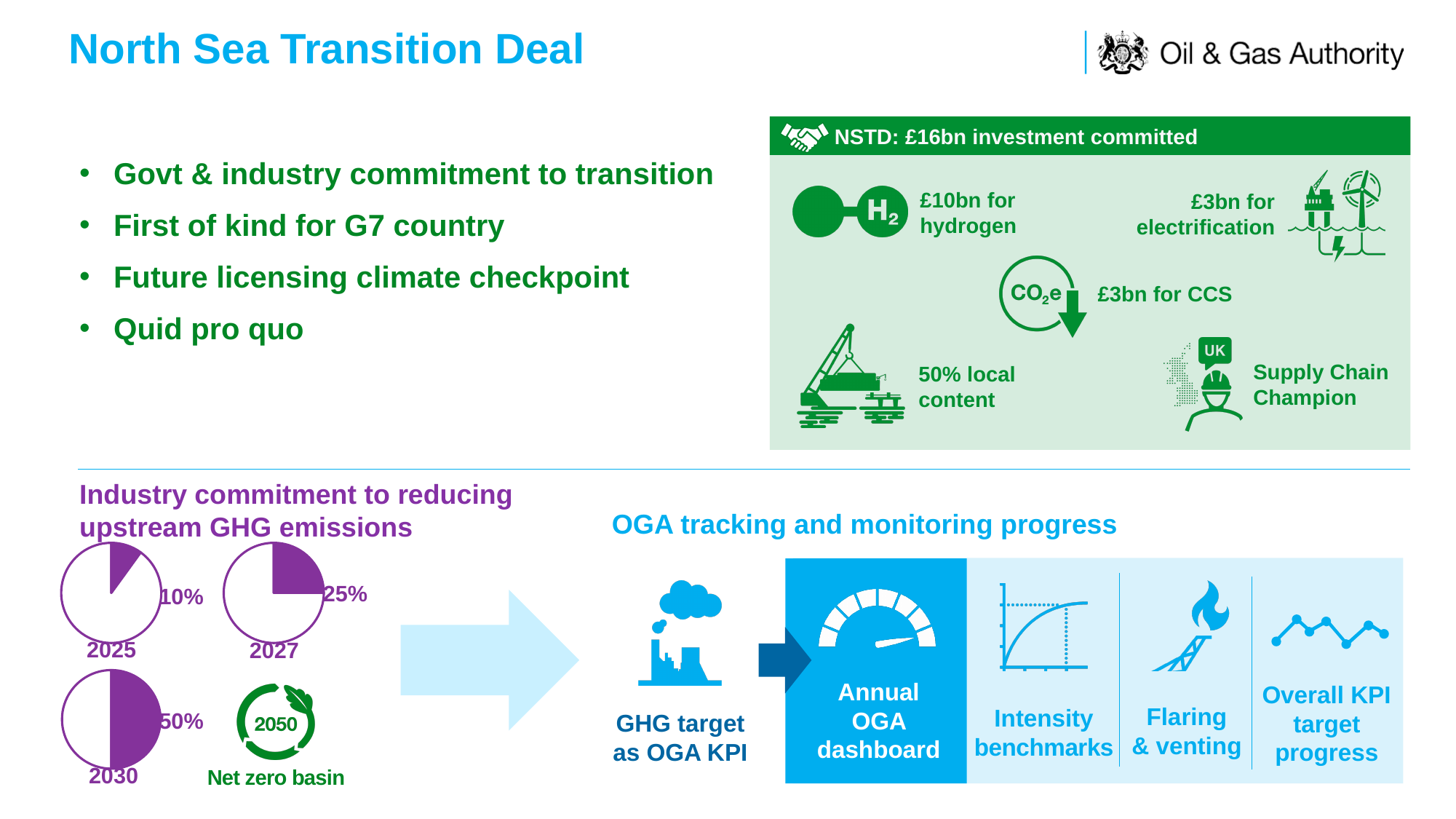
In the 'Industry commitment to reducing upstream GHG emissions' graphic, which year has the largest percentage shown? 2030 In the 'Industry commitment to reducing upstream GHG emissions' graphic, what is the difference between the 2027 and 2025 percentages? 15% How many percentage pie graphics are shown under 'Industry commitment to reducing upstream GHG emissions'? 3 In the 'Industry commitment to reducing upstream GHG emissions' graphic, which year has the smallest percentage shown? 2025 What colour are the filled slices in the GHG emissions reduction pie graphics? Purple In the 'Industry commitment to reducing upstream GHG emissions' graphic, which is larger, the 2025 value or the 2027 value? 2027 In the 'Industry commitment to reducing upstream GHG emissions' graphic, what percentage is shown for 2027? 25% In the 'Industry commitment to reducing upstream GHG emissions' graphic, what percentage is shown for 2025? 10% Do the percentages in the 'Industry commitment to reducing upstream GHG emissions' graphic rise or fall from 2025 to 2030? Rise In the 'Industry commitment to reducing upstream GHG emissions' graphic, what is the difference between the 2030 and 2027 percentages? 25% What kind of chart is used to show the GHG emission reduction percentages for 2025, 2027 and 2030? Pie chart In the 'Industry commitment to reducing upstream GHG emissions' graphic, what percentage is shown for 2030? 50%